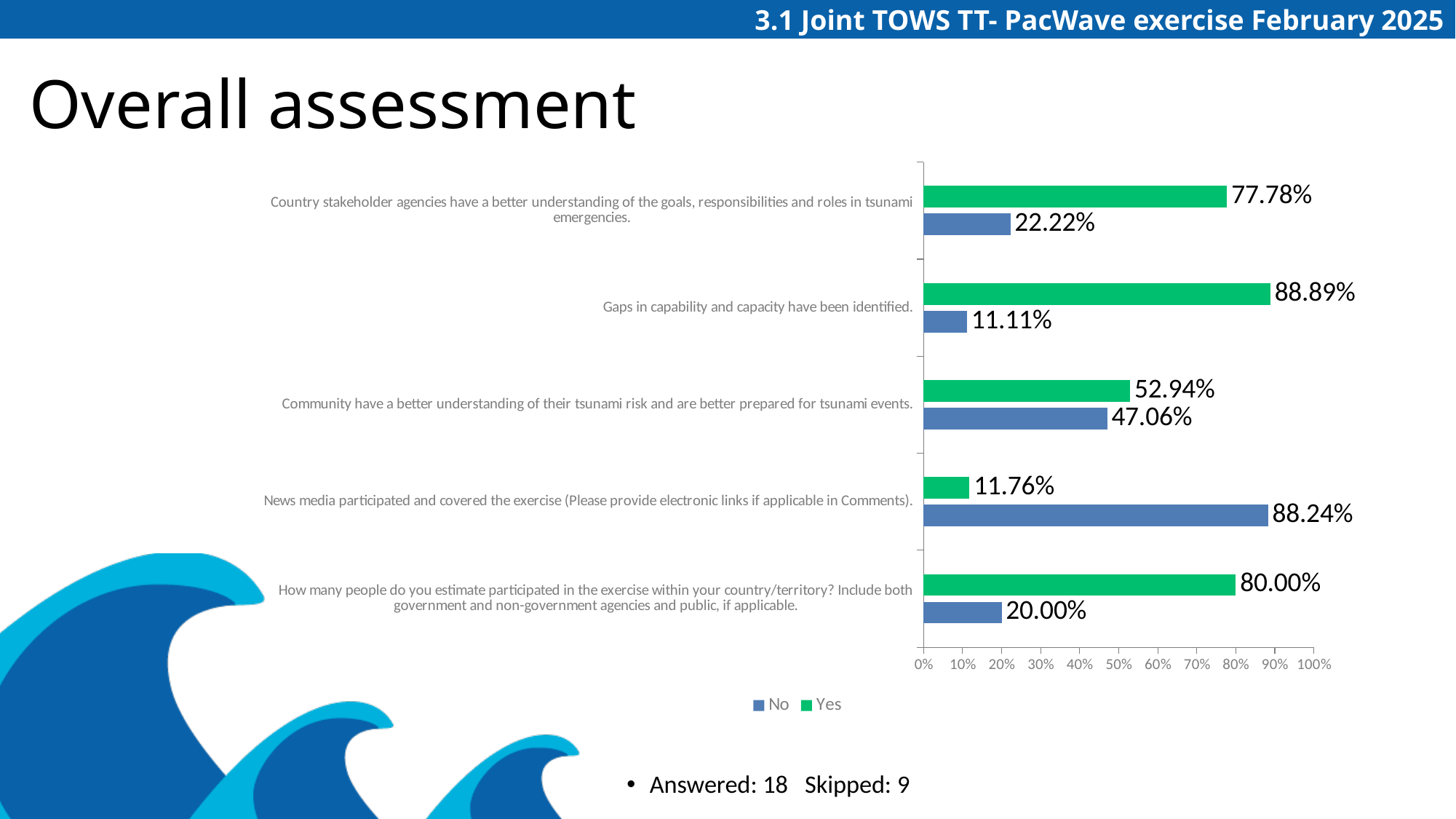
What is the 'No' value for 'News media participated and covered the exercise'? 88.24% What kind of chart is shown on the slide? Bar chart Which category has the lowest 'Yes' value? News media participated and covered the exercise For 'How many people do you estimate participated in the exercise within your country/territory?', which is larger, the 'Yes' value or the 'No' value? Yes How many categories are shown on the chart? 5 Which colour represents the 'Yes' series in the chart? Green What is the 'Yes' value for 'Gaps in capability and capacity have been identified.'? 88.89% What is the 'Yes' value for 'Country stakeholder agencies have a better understanding of the goals, responsibilities and roles in tsunami emergencies.'? 77.78% What is the difference between the 'Yes' and 'No' values for 'Community have a better understanding of their tsunami risk and are better prepared for tsunami events.'? 5.88% Which category has the highest 'Yes' value? Gaps in capability and capacity have been identified. How many series does the legend list? 2 What is the 'No' value for 'Community have a better understanding of their tsunami risk and are better prepared for tsunami events.'? 47.06%